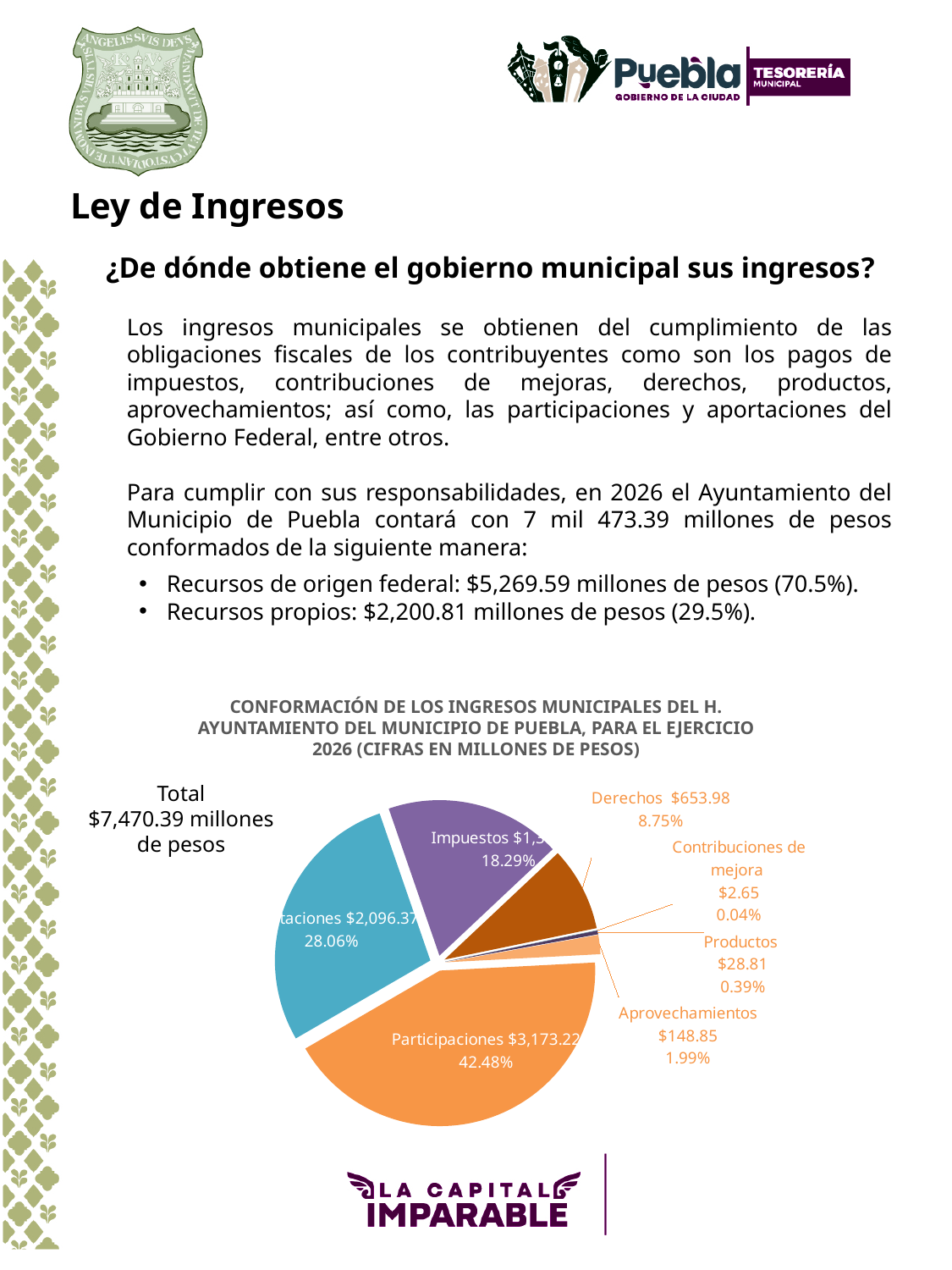
Which is larger in the pie chart, Derechos or Aprovechamientos? Derechos What percentage share does Derechos have in the pie chart? 8.75% How many slices does the pie chart have? 7 Which category has the largest slice in the pie chart? Participaciones What is the difference between the values for Derechos and Aprovechamientos in the pie chart? $505.13 What percentage share does Participaciones have in the pie chart? 42.48% What is the value shown for Derechos in the pie chart? $653.98 Which category has the smallest slice in the pie chart? Contribuciones de mejora What kind of chart is shown on the slide? pie chart What total is shown next to the pie chart? $7,470.39 millones de pesos What percentage share does Aprovechamientos have in the pie chart? 1.99% What is the value shown for Productos in the pie chart? $28.81